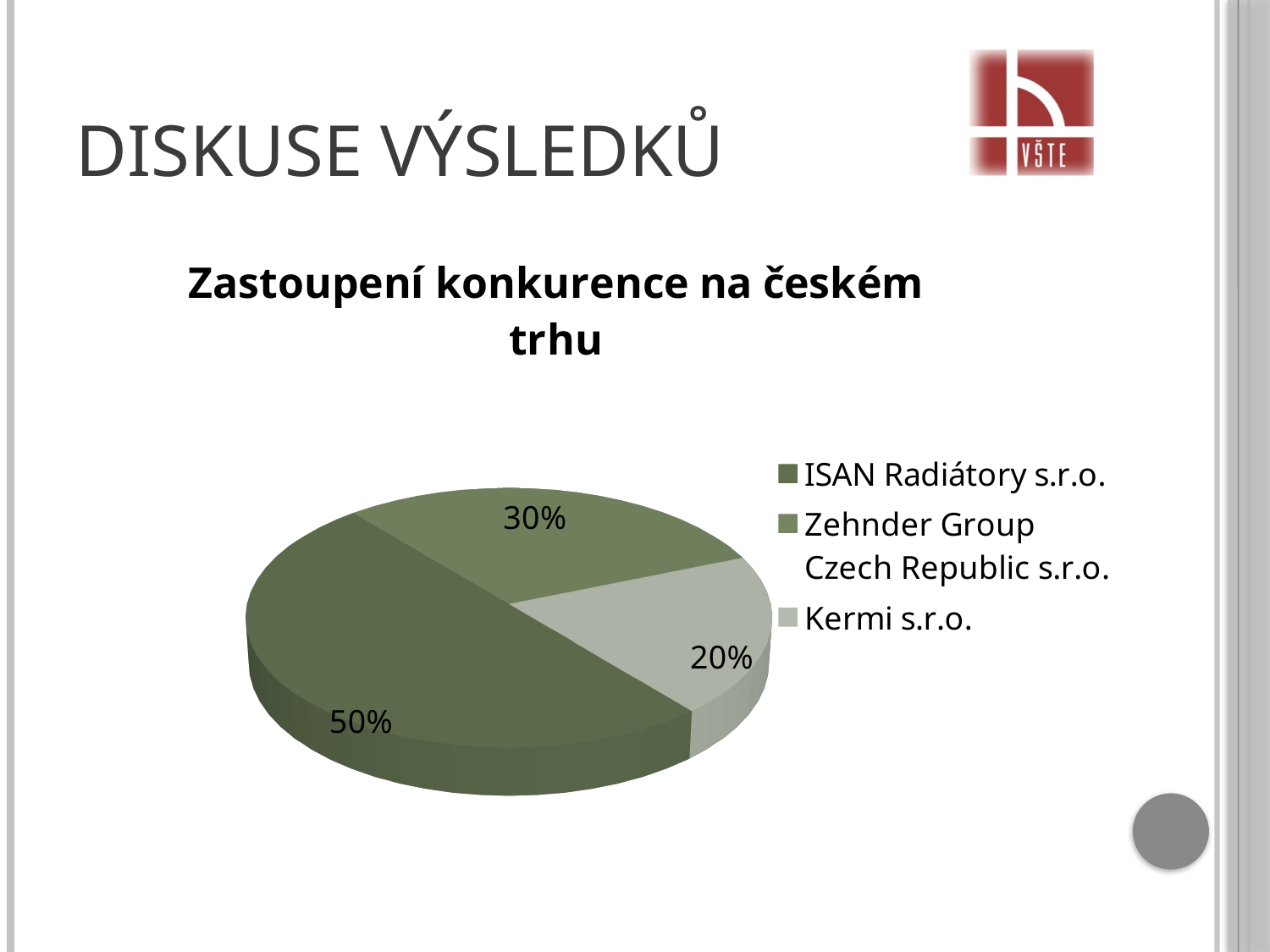
How many companies are shown in the pie chart? 3 What share of the pie does ISAN Radiátory s.r.o. hold? 50% What kind of chart is shown on the slide? Pie chart Which has a larger share, Zehnder Group Czech Republic s.r.o. or Kermi s.r.o.? Zehnder Group Czech Republic s.r.o. What is the difference in percentage points between the shares of ISAN Radiátory s.r.o. and Kermi s.r.o.? 30% What share of the pie does Zehnder Group Czech Republic s.r.o. hold? 30% What is the difference in percentage points between the shares of Zehnder Group Czech Republic s.r.o. and Kermi s.r.o.? 10% How many entries does the chart legend list? 3 What share of the pie does Kermi s.r.o. hold? 20% Which company has the smallest share of the Czech market in the chart? Kermi s.r.o. Which company has the largest share of the Czech market in the chart? ISAN Radiátory s.r.o. What is the title of the chart? Zastoupení konkurence na českém trhu